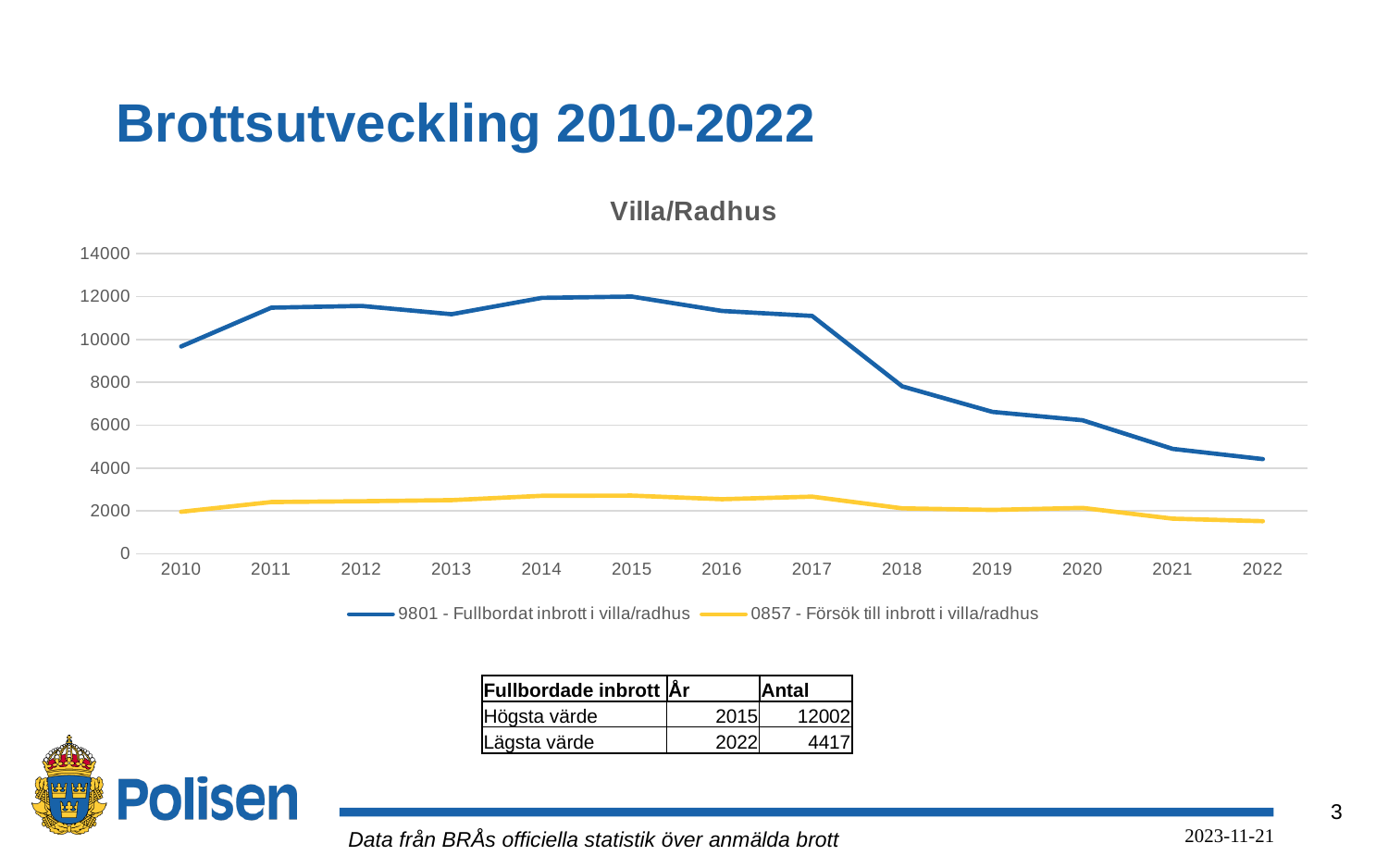
What is the lowest value of Fullbordade inbrott, as given in the table below the chart? 4417 What is the highest value of Fullbordade inbrott, as given in the table below the chart? 12002 What is the difference between the highest (2015) and lowest (2022) values of Fullbordade inbrott shown in the table? 7585 Does the series 9801 - Fullbordat inbrott i villa/radhus rise or fall from 2017 to 2022? fall Is the value for 0857 - Försök till inbrott i villa/radhus in 2015 greater or less than 2000? greater How many series does the legend of the Villa/Radhus chart list? 2 How many years are shown on the x axis of the Villa/Radhus chart? 13 Is the value for 9801 - Fullbordat inbrott i villa/radhus in 2010 greater or less than 10000? less Which series has the larger value in 2015: 9801 - Fullbordat inbrott i villa/radhus or 0857 - Försök till inbrott i villa/radhus? 9801 - Fullbordat inbrott i villa/radhus What kind of chart is shown under the title Villa/Radhus? line chart In which year does the series 9801 - Fullbordat inbrott i villa/radhus reach its highest value? 2015 In which year does the series 9801 - Fullbordat inbrott i villa/radhus reach its lowest value? 2022